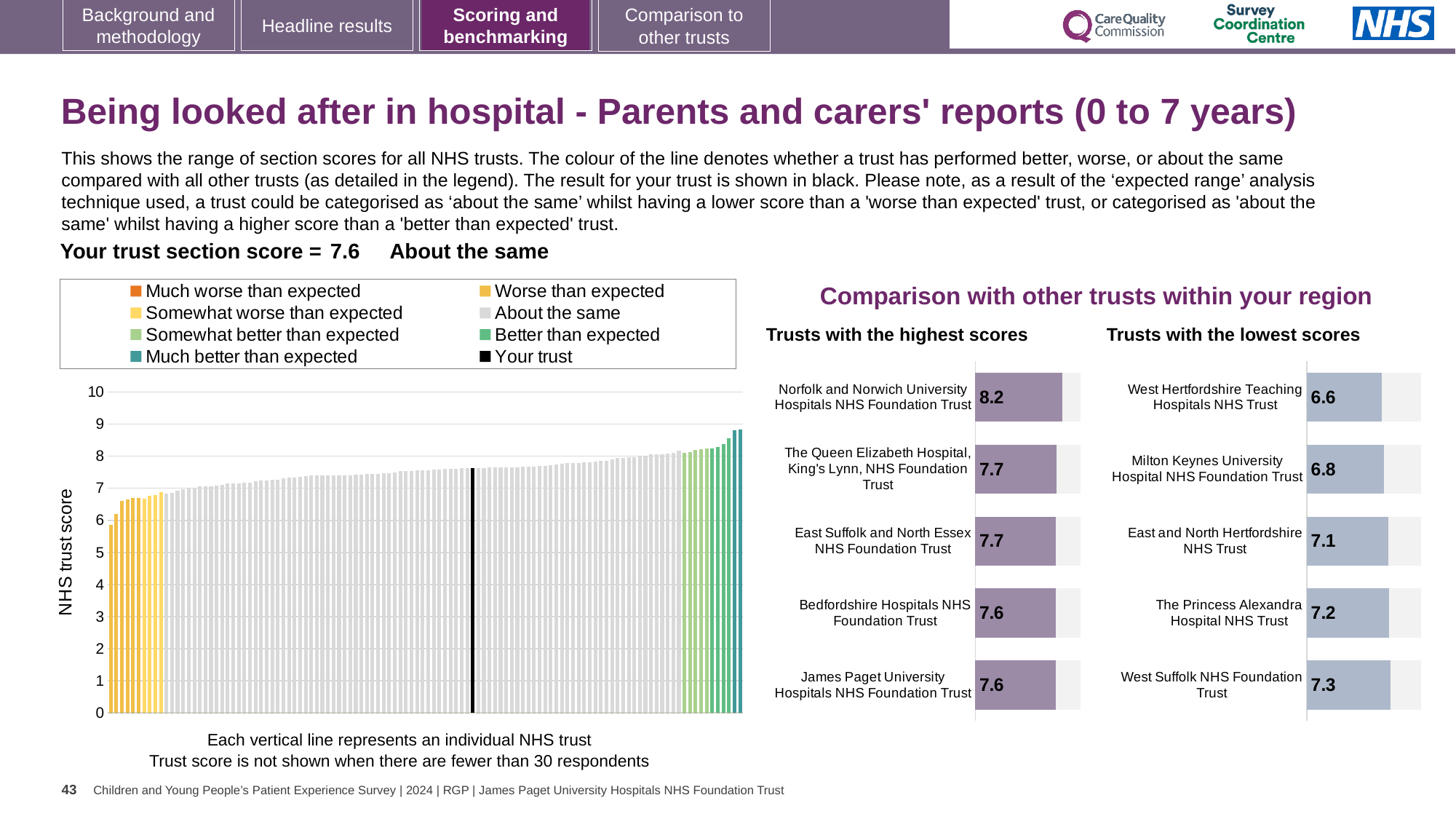
In the main NHS trust score chart, is the value of the tallest bar greater or less than 8? greater In the 'Trusts with the highest scores' chart, what is the difference between the scores of Norfolk and Norwich University Hospitals NHS Foundation Trust and Bedfordshire Hospitals NHS Foundation Trust? 0.6 In the main NHS trust score chart, do the bar values rise or fall from left to right? Rise How many entries does the legend of the main NHS trust score chart list? 8 In the 'Trusts with the lowest scores' chart, what is the difference between the scores of West Suffolk NHS Foundation Trust and West Hertfordshire Teaching Hospitals NHS Trust? 0.7 In the 'Trusts with the lowest scores' chart, which has the larger score: Milton Keynes University Hospital NHS Foundation Trust or East and North Hertfordshire NHS Trust? East and North Hertfordshire NHS Trust In the 'Trusts with the lowest scores' chart, which trust has the lowest score? West Hertfordshire Teaching Hospitals NHS Trust How many trusts are shown in the 'Trusts with the highest scores' chart? 5 In the 'Trusts with the highest scores' chart, which trust has the highest score? Norfolk and Norwich University Hospitals NHS Foundation Trust In the 'Trusts with the lowest scores' chart, what is the score for Milton Keynes University Hospital NHS Foundation Trust? 6.8 What kind of chart is the main chart showing the range of NHS trust scores? Bar chart In the 'Trusts with the highest scores' chart, what is the score for Norfolk and Norwich University Hospitals NHS Foundation Trust? 8.2